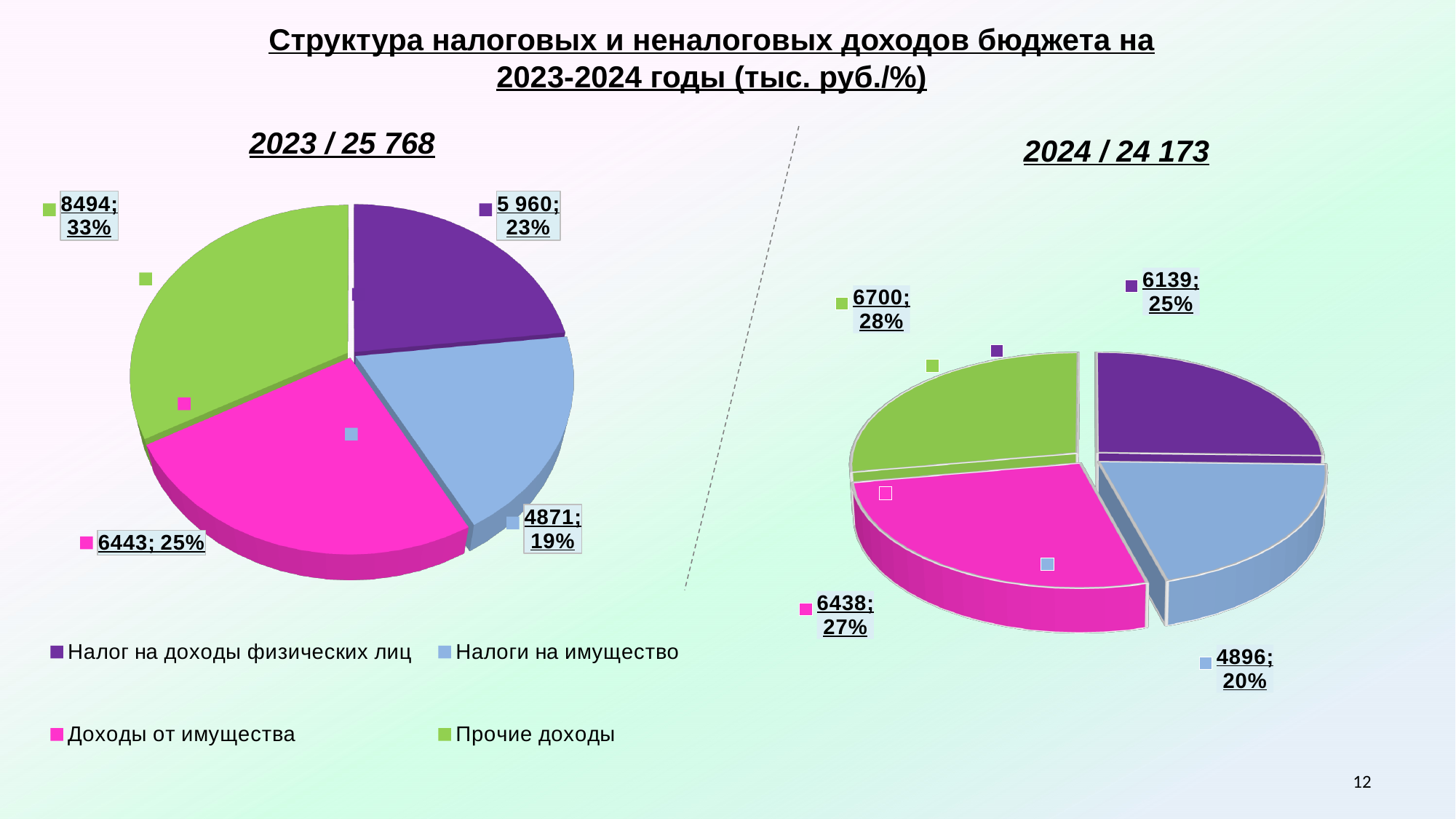
In the 2024 / 24 173 chart, which category has the smallest slice? Налоги на имущество In the 2023 / 25 768 chart, what is the difference between Прочие доходы and Доходы от имущества? 2051 In the 2024 / 24 173 chart, what share of the pie does Прочие доходы have? 28% How many categories does the legend list? 4 In the 2024 / 24 173 chart, what is the value for Налог на доходы физических лиц? 6139; 25% In the 2023 / 25 768 chart, which category has the largest slice? Прочие доходы Which is larger in the 2024 / 24 173 chart: Налог на доходы физических лиц or Налоги на имущество? Налог на доходы физических лиц In the 2023 / 25 768 chart, what is the value for Прочие доходы? 8494; 33% In the 2024 / 24 173 chart, what is the value for Доходы от имущества? 6438; 27% In the 2023 / 25 768 chart, what is the value for Налоги на имущество? 4871; 19% What type of chart is used on this slide? Pie chart In the 2023 / 25 768 chart, what share of the pie does Налог на доходы физических лиц have? 23%